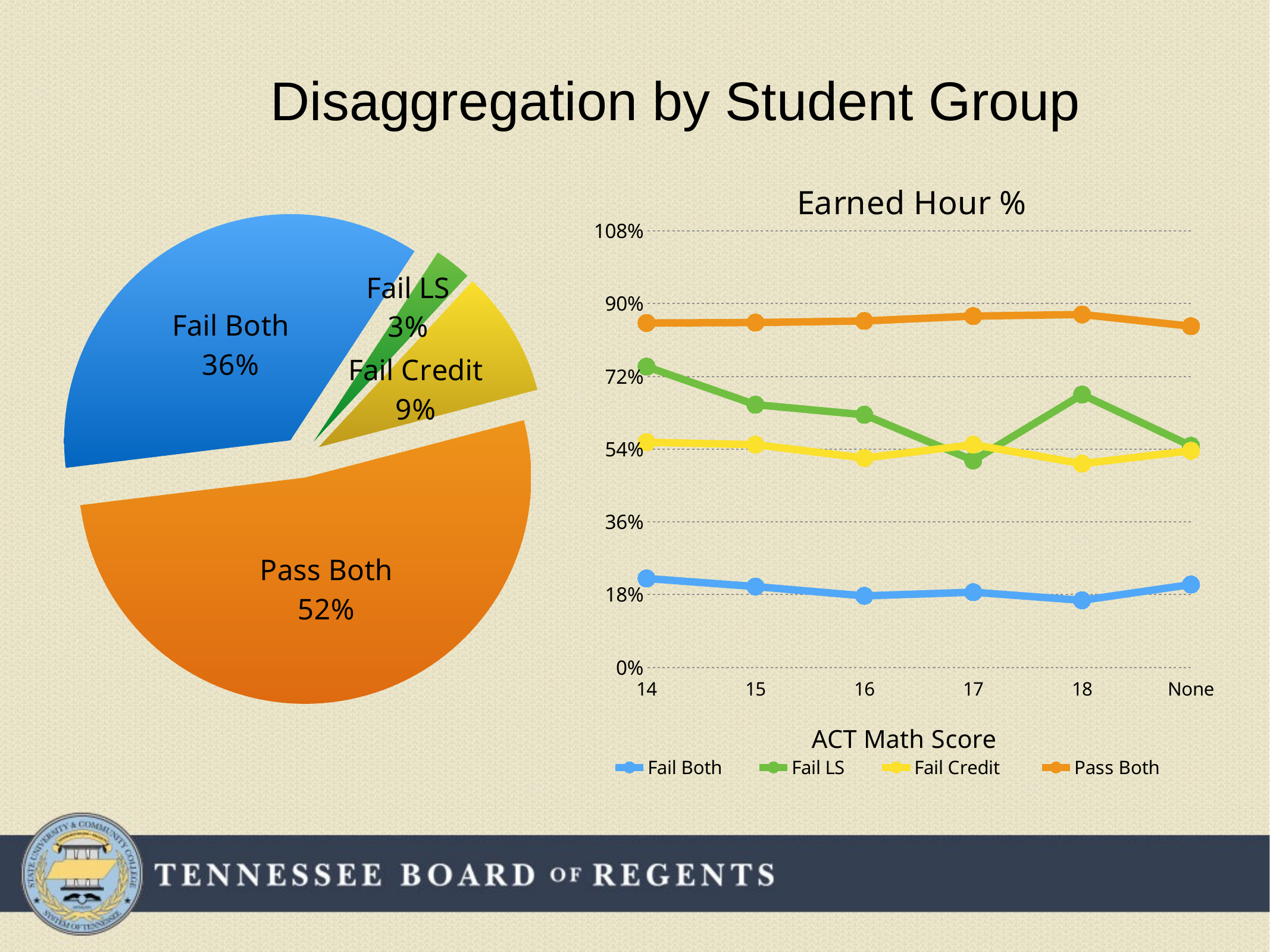
In the pie chart on the left, how many categories are shown? 4 In the pie chart on the left, what is the value for Fail Both? 36% In the Earned Hour % chart, is the value for Fail Both at ACT Math Score 18 greater or less than 18%? less In the pie chart on the left, what share of the pie is Pass Both? 52% What kind of chart is the Earned Hour % chart? Line chart In the pie chart on the left, what is the value for Fail Credit? 9% In the pie chart on the left, which category has the smallest slice? Fail LS In the pie chart on the left, what is the difference between the Fail Both and Fail Credit shares? 27% In the Earned Hour % chart, is the value for Pass Both at ACT Math Score 14 greater or less than 90%? less In the Earned Hour % chart, which series has the highest values across all ACT Math Scores? Pass Both In the Earned Hour % chart, how many series does the legend list? 4 In the pie chart on the left, which category has the largest slice? Pass Both